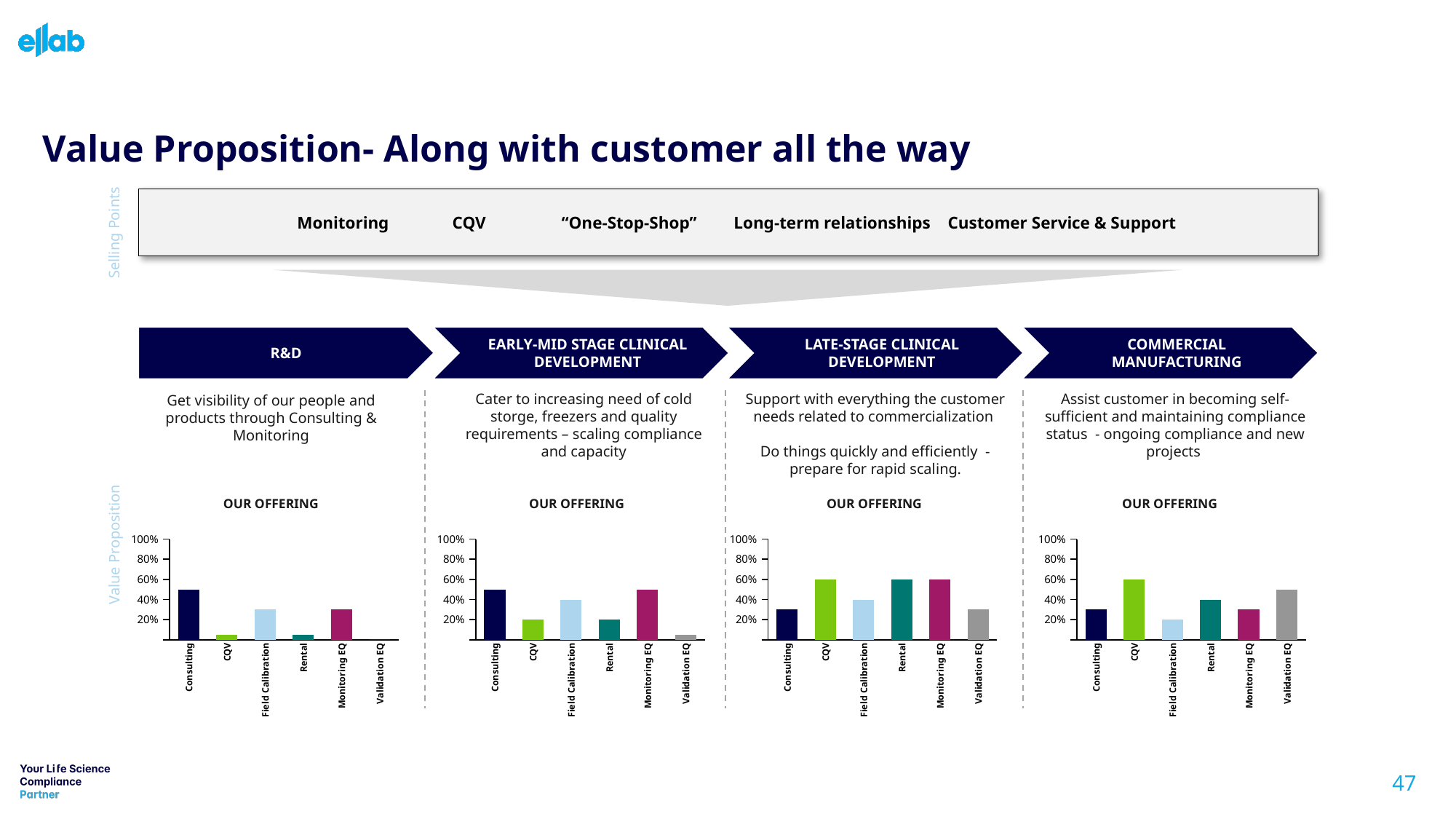
In the Commercial Manufacturing chart, which category has the lowest value? Field Calibration In the Commercial Manufacturing chart, what is the value for Field Calibration? 20% In the Early-Mid Stage Clinical Development chart, is the value for Validation EQ greater or less than 20%? less In the Late-Stage Clinical Development chart, is the value for Consulting greater or less than 40%? less In the R&D chart, is the value for CQV greater or less than 20%? less In the Early-Mid Stage Clinical Development chart, which is larger, Consulting or CQV? Consulting What kind of chart is shown under OUR OFFERING in the R&D section? bar chart In the Commercial Manufacturing chart, which category has the highest value? CQV How many bar charts are shown on the slide? 4 How many categories are plotted in the Commercial Manufacturing OUR OFFERING chart? 6 In the Late-Stage Clinical Development chart, what is the value for CQV? 60%